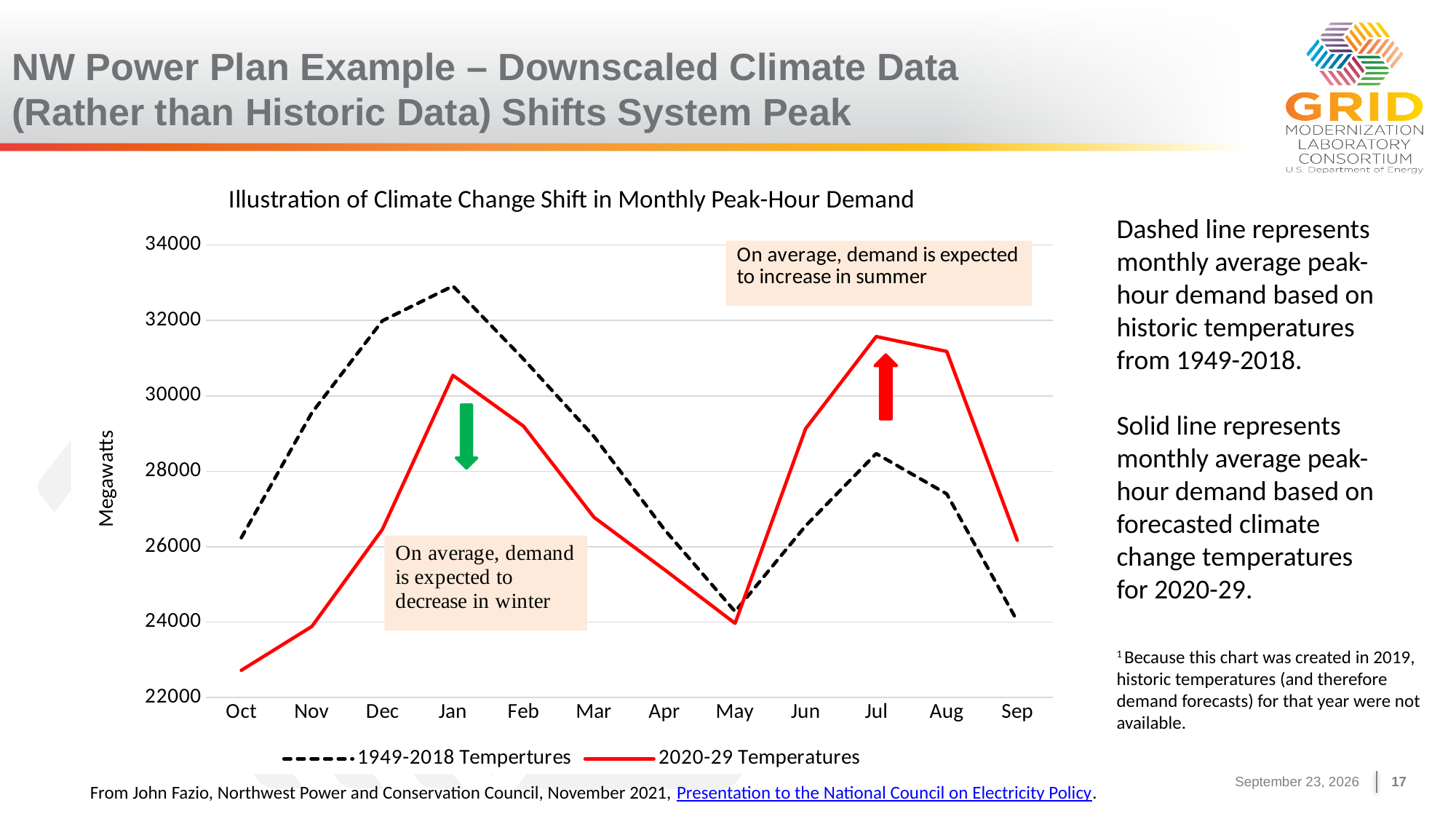
Is the value for the 2020-29 Temperatures series in Oct greater or less than 24000? less In which month is the 2020-29 Temperatures series at its lowest value? Oct What is the title of the chart? Illustration of Climate Change Shift in Monthly Peak-Hour Demand Does the 2020-29 Temperatures series rise or fall from Oct to Jan? rise How many series does the legend list? 2 In Jul, which series has the higher value: 1949-2018 Tempertures or 2020-29 Temperatures? 2020-29 Temperatures In which month does the 2020-29 Temperatures series reach its highest value? Jul In Jan, which series has the higher value: 1949-2018 Tempertures or 2020-29 Temperatures? 1949-2018 Tempertures Is the value for the 1949-2018 Tempertures series in Jan greater or less than 32000? greater In which month does the 1949-2018 Tempertures series reach its highest value? Jan What kind of chart is shown on the slide? Line chart How many months are plotted along the x axis? 12